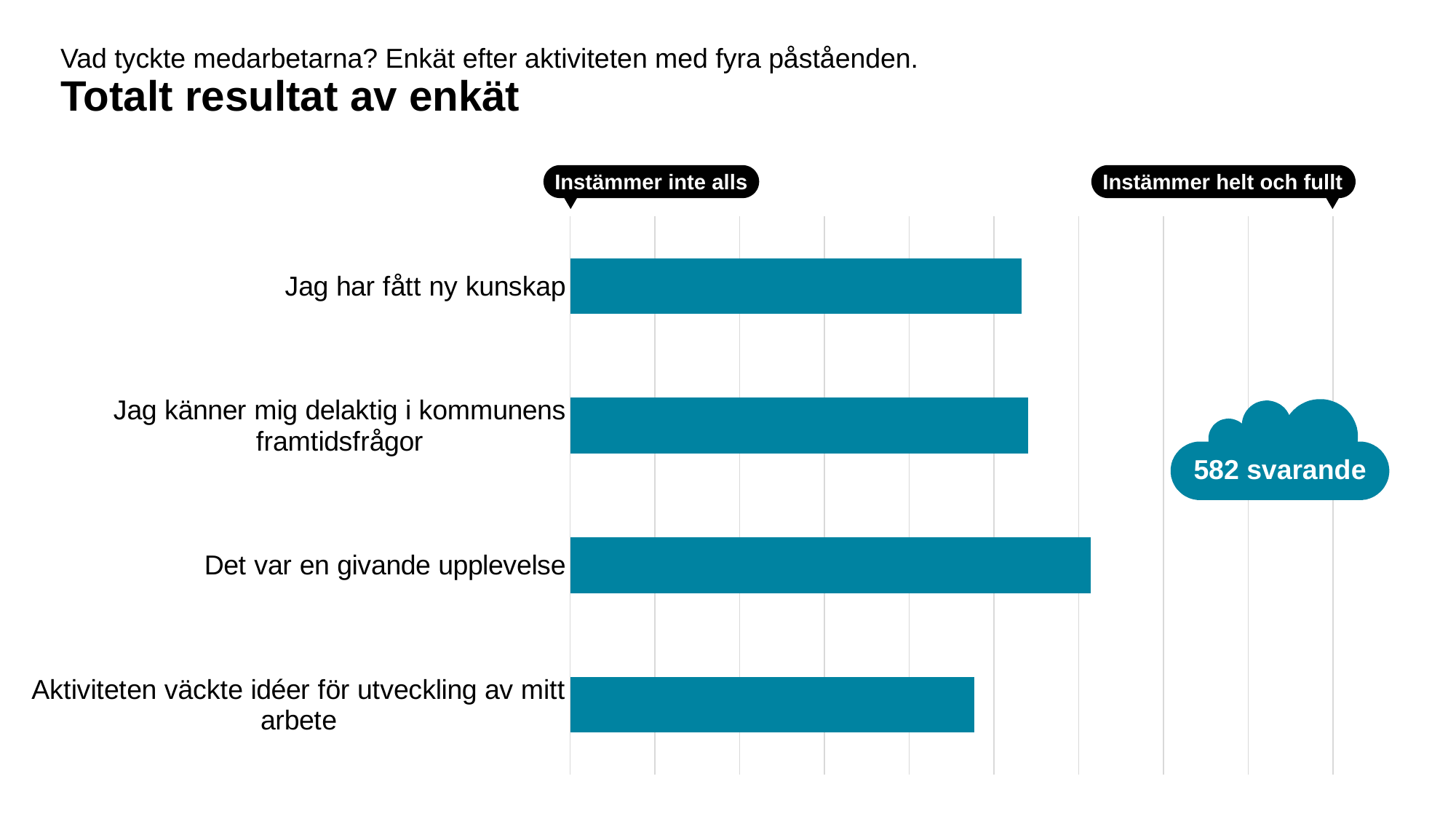
What is the title of the chart on the slide? Totalt resultat av enkät How many statements (categories) are plotted in the chart? 4 Which has the longer bar: "Jag har fått ny kunskap" or "Aktiviteten väckte idéer för utveckling av mitt arbete"? Jag har fått ny kunskap Which statement has the lowest level of agreement (shortest bar)? Aktiviteten väckte idéer för utveckling av mitt arbete Which statement has the highest level of agreement (longest bar)? Det var en givande upplevelse What kind of chart is shown on the slide? Bar chart How many respondents does the slide say answered the survey? 582 svarande Which has the longer bar: "Det var en givande upplevelse" or "Aktiviteten väckte idéer för utveckling av mitt arbete"? Det var en givande upplevelse Which has the longer bar: "Det var en givande upplevelse" or "Jag har fått ny kunskap"? Det var en givande upplevelse